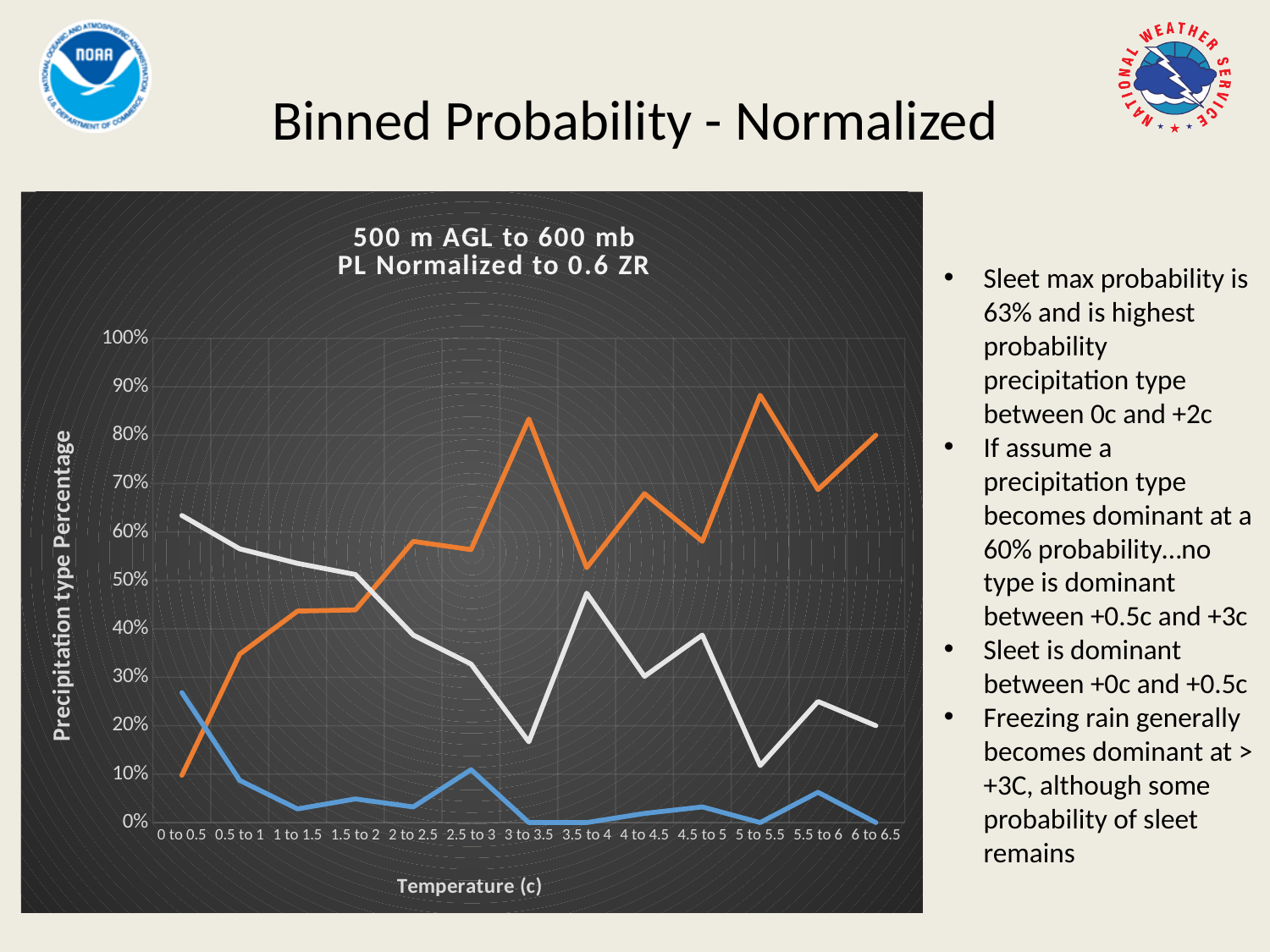
Does the blue line generally rise or fall as temperature increases along the x axis? fall At which temperature bin does the white line reach its highest value? 0 to 0.5 What is the title of the chart? 500 m AGL to 600 mb PL Normalized to 0.6 ZR What is the label of the x axis of the chart? Temperature (c) Is the value of the orange line at "0 to 0.5" greater or less than 20%? less Is the value of the orange line at "5 to 5.5" greater or less than 80%? greater At which temperature bin does the orange line reach its highest value? 5 to 5.5 How many temperature bins are shown along the x axis of the chart? 13 Is the value of the blue line at "3 to 3.5" greater or less than 10%? less At "6 to 6.5", which line has the larger value, the orange line or the white line? orange What kind of chart is shown on the slide? line chart